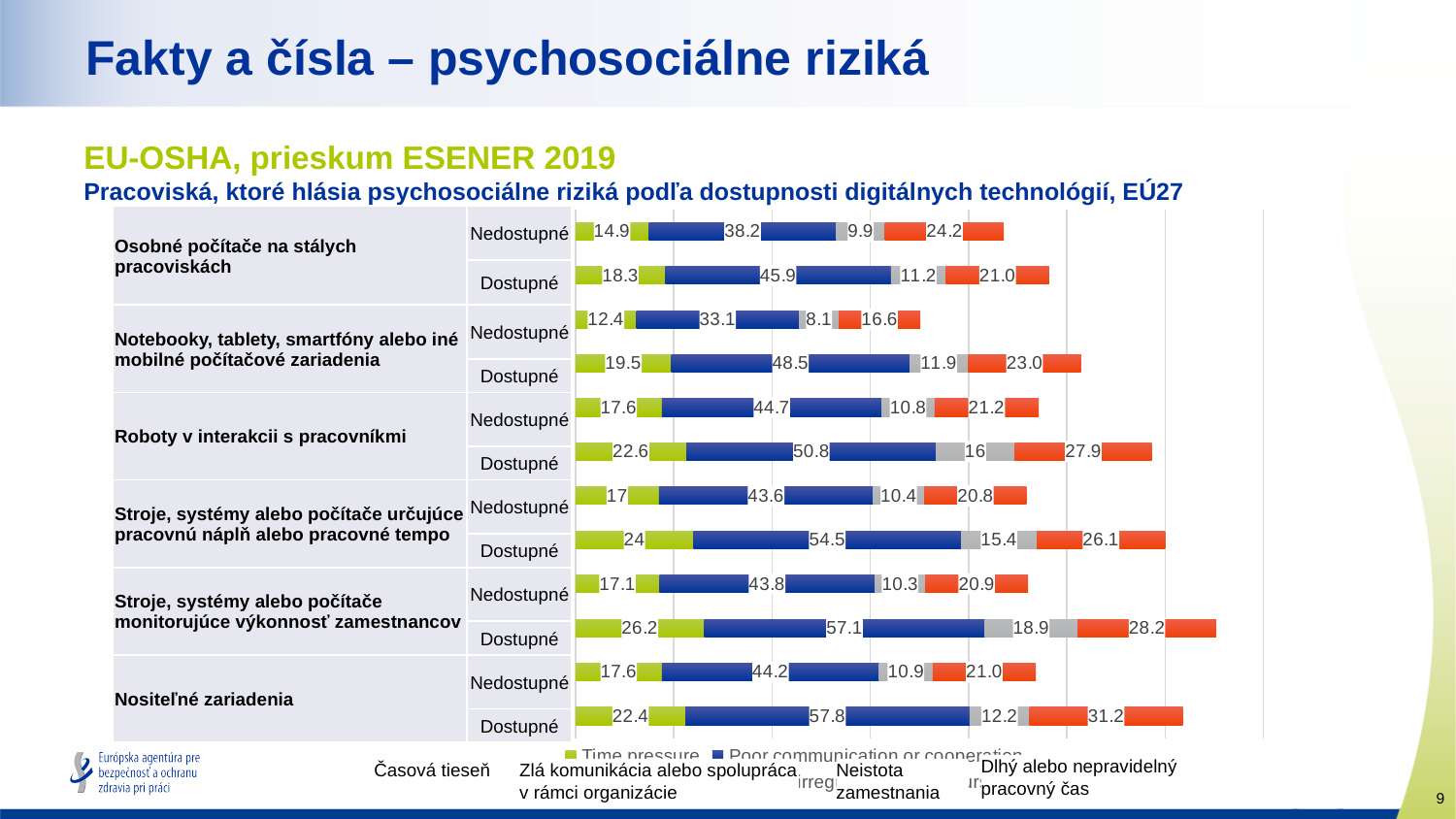
What is the value of Časová tieseň for Nositeľné zariadenia, Dostupné? 22.4 How many bars are plotted in the chart? 12 What is the value of Neistota zamestnania for Roboty v interakcii s pracovníkmi, Dostupné? 16 Which is larger: Časová tieseň for Stroje, systémy alebo počítače určujúce pracovnú náplň alebo pracovné tempo, Dostupné, or for Roboty v interakcii s pracovníkmi, Dostupné? Stroje, systémy alebo počítače určujúce pracovnú náplň alebo pracovné tempo, Dostupné What is the value of Dlhý alebo nepravidelný pracovný čas for Notebooky, tablety, smartfóny alebo iné mobilné počítačové zariadenia, Nedostupné? 16.6 What kind of chart is shown on the slide? stacked bar chart How many series does the legend list? 4 What is the value of Zlá komunikácia alebo spolupráca v rámci organizácie for Stroje, systémy alebo počítače monitorujúce výkonnosť zamestnancov, Dostupné? 57.1 What is the total of the stacked bar for Notebooky, tablety, smartfóny alebo iné mobilné počítačové zariadenia, Nedostupné? 70.2 Which bar has the lowest value for Časová tieseň? Notebooky, tablety, smartfóny alebo iné mobilné počítačové zariadenia, Nedostupné Which bar has the highest value for Dlhý alebo nepravidelný pracovný čas? Nositeľné zariadenia, Dostupné What is the difference in Zlá komunikácia alebo spolupráca v rámci organizácie between Dostupné and Nedostupné for Osobné počítače na stálych pracoviskách? 7.7